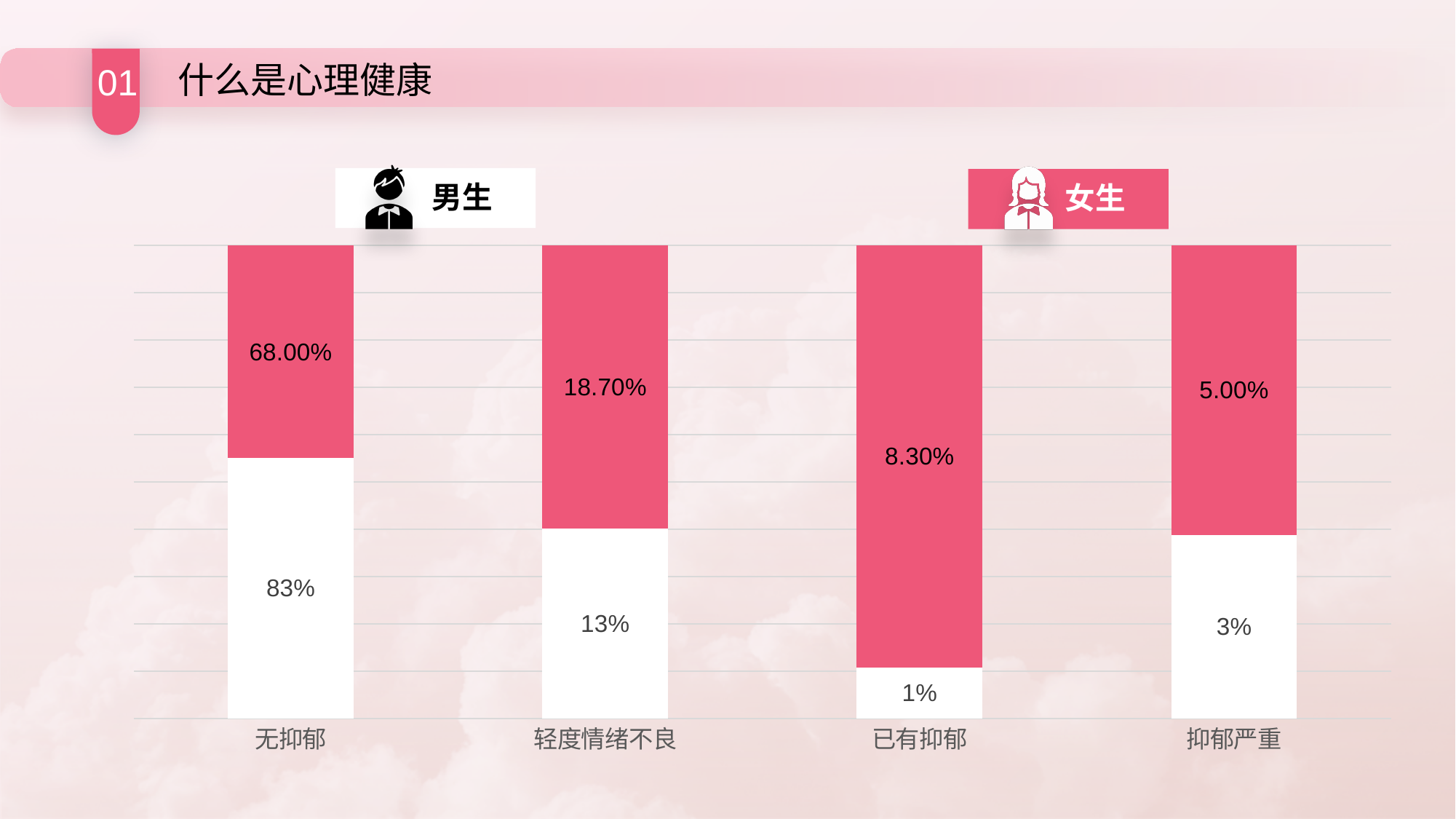
Which category has the lowest value for 男生? 已有抑郁 What is the value for 女生 in the 抑郁严重 category? 5.00% What is the value for 男生 in the 无抑郁 category? 83% In the 已有抑郁 category, which is larger, the 男生 value or the 女生 value? 女生 What is the value for 男生 in the 已有抑郁 category? 1% How many categories are shown on the x axis? 4 Which category has the highest value for 女生? 无抑郁 Do the 女生 values rise or fall from 无抑郁 to 抑郁严重 along the x axis? Fall What is the difference between the 男生 and 女生 values in the 无抑郁 category? 15% What kind of chart is shown on the slide? Stacked bar chart What is the value for 女生 in the 轻度情绪不良 category? 18.70%